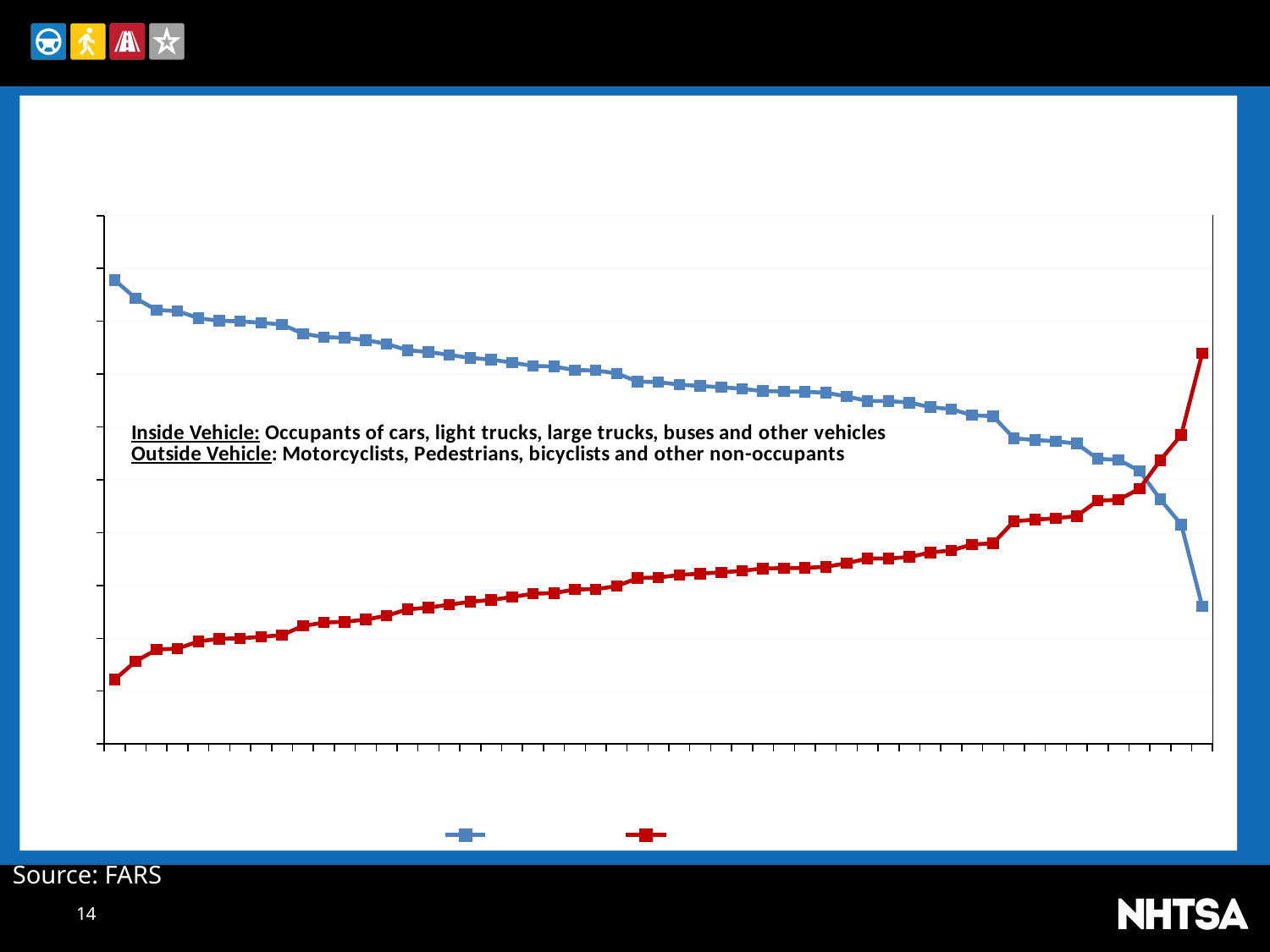
At the leftmost point of the chart, which series is higher, the blue or the red? blue At the rightmost point of the chart, which series is higher, the blue or the red? red How many series does the legend below the chart show? 2 Which series has the lowest point on the chart, the blue or the red? red Does the red series rise or fall from left to right along the x axis? rise Does the blue series rise or fall from left to right along the x axis? fall What colours are the two series plotted in? blue and red Which series reaches the highest point on the chart, the blue or the red? blue What kind of chart is shown on the slide? line chart Do the two lines cross each other on the chart? yes